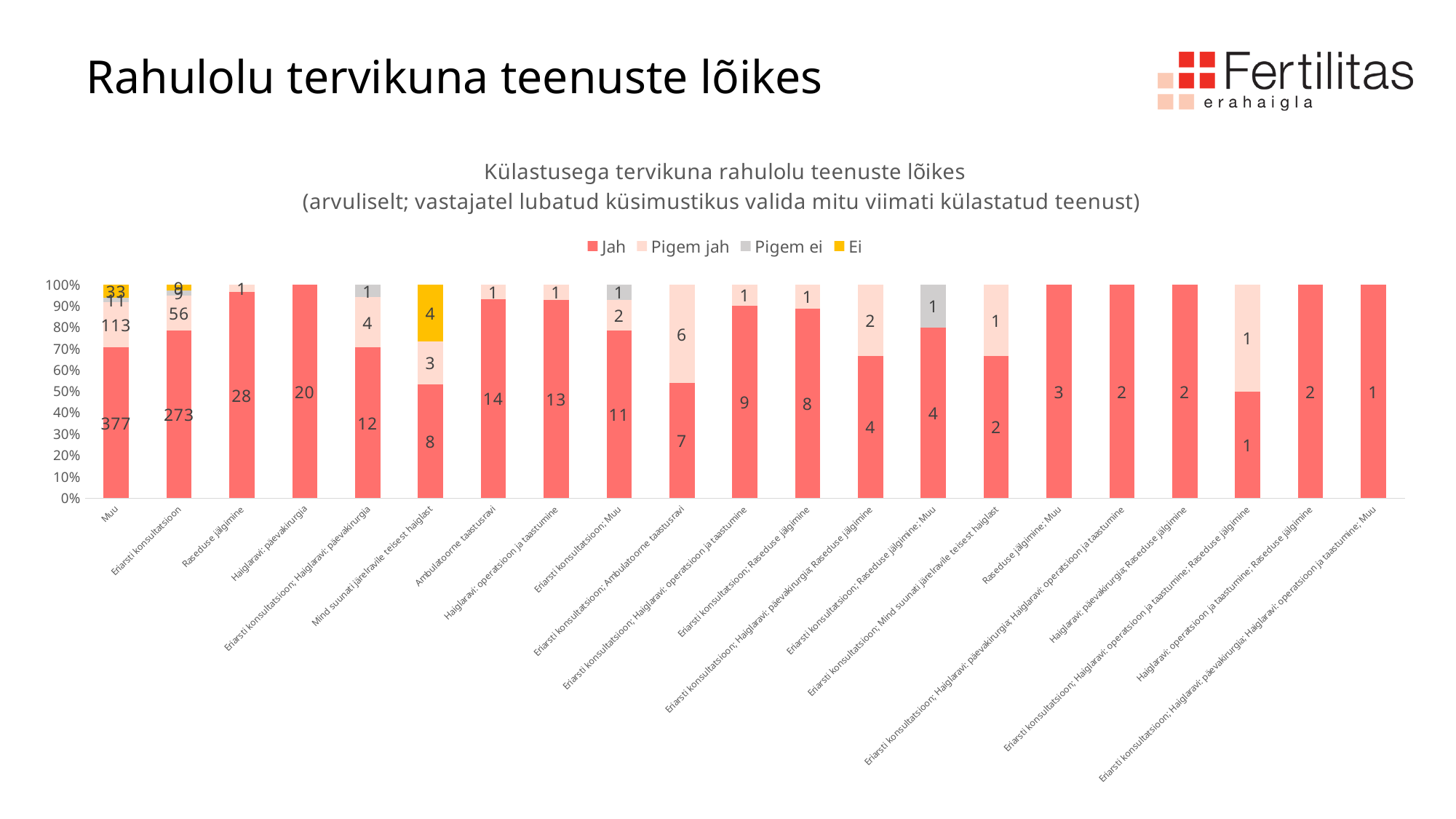
Which is larger: the 'Jah' value for 'Raseduse jälgimine' or for 'Ambulatoorne taastusravi'? Raseduse jälgimine What is the 'Pigem jah' value for the 'Eriarsti konsultatsioon; Ambulatoorne taastusravi' category? 6 What type of chart is shown on the slide? Stacked bar chart What is the 'Jah' value for the 'Muu' category? 377 How many series does the legend list? 4 What is the 'Ei' value for the 'Mind suunati järelravile teisest haiglast' category? 4 What is the difference between the 'Jah' values for 'Muu' and 'Eriarsti konsultatsioon'? 104 What is the total number of responses shown for the 'Mind suunati järelravile teisest haiglast' bar? 15 What is the 'Jah' value for the 'Haiglaravi: päevakirurgia' category? 20 Which category has the highest 'Jah' value? Muu What is the total number of responses shown for the 'Muu' bar? 534 What is the 'Pigem jah' value for the 'Muu' category? 113